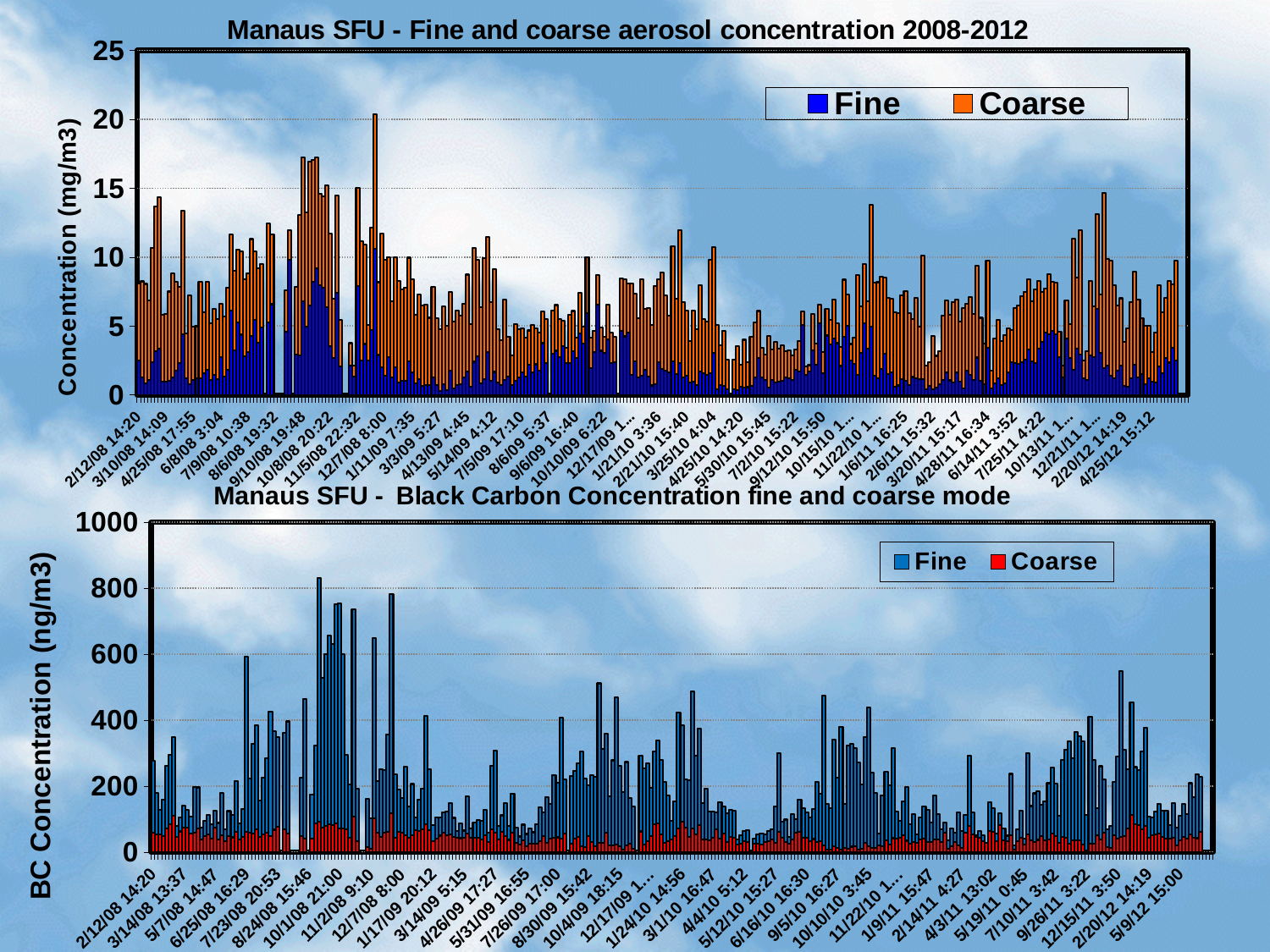
What is the title of the bottom chart? Manaus SFU - Black Carbon Concentration fine and coarse mode In the top chart, which series generally contributes more to each bar, Fine or Coarse? Coarse How many series does the legend of the top chart list? 2 What is the y-axis label of the bottom chart? BC Concentration (ng/m3) In the top chart, is the tallest stacked bar greater or less than 15 mg/m3? greater In the top chart, is the maximum value shown on the y-axis greater or less than 20? greater What is the title of the top chart? Manaus SFU - Fine and coarse aerosol concentration 2008-2012 What kind of chart is the bottom chart, 'Manaus SFU - Black Carbon Concentration fine and coarse mode'? Stacked bar chart In the bottom chart, is the tallest stacked bar greater or less than 600 ng/m3? greater What kind of chart is the top chart, 'Manaus SFU - Fine and coarse aerosol concentration 2008-2012'? Stacked bar chart How many series does the legend of the bottom chart list? 2 In the bottom chart, which series generally contributes more to each bar, Fine or Coarse? Fine